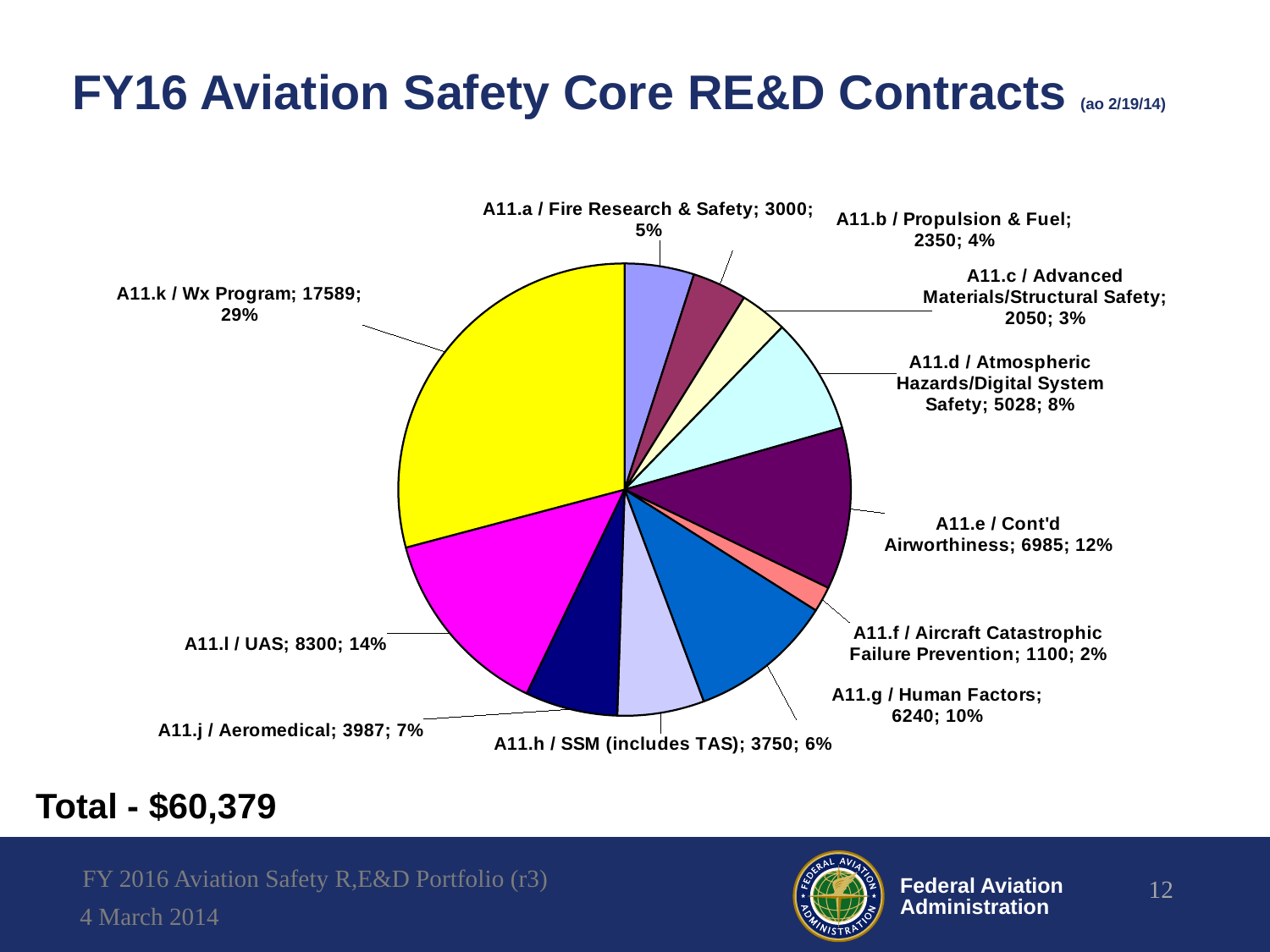
What is the value for A11.g / Human Factors? 6240 How many slices does the pie chart have? 11 What is the title of the slide containing the pie chart? FY16 Aviation Safety Core RE&D Contracts What kind of chart is shown on the slide? Pie chart What percentage share does A11.l / UAS have? 14% Which category has the largest slice of the pie? A11.k / Wx Program What is the value for A11.k / Wx Program? 17589 Which category has the smallest slice of the pie? A11.f / Aircraft Catastrophic Failure Prevention What total is stated below the pie chart? $60,379 What percentage share does A11.d / Atmospheric Hazards/Digital System Safety have? 8% What is the difference between the values for A11.e / Cont'd Airworthiness and A11.g / Human Factors? 745 Which is larger, the value for A11.j / Aeromedical or A11.h / SSM (includes TAS)? A11.j / Aeromedical